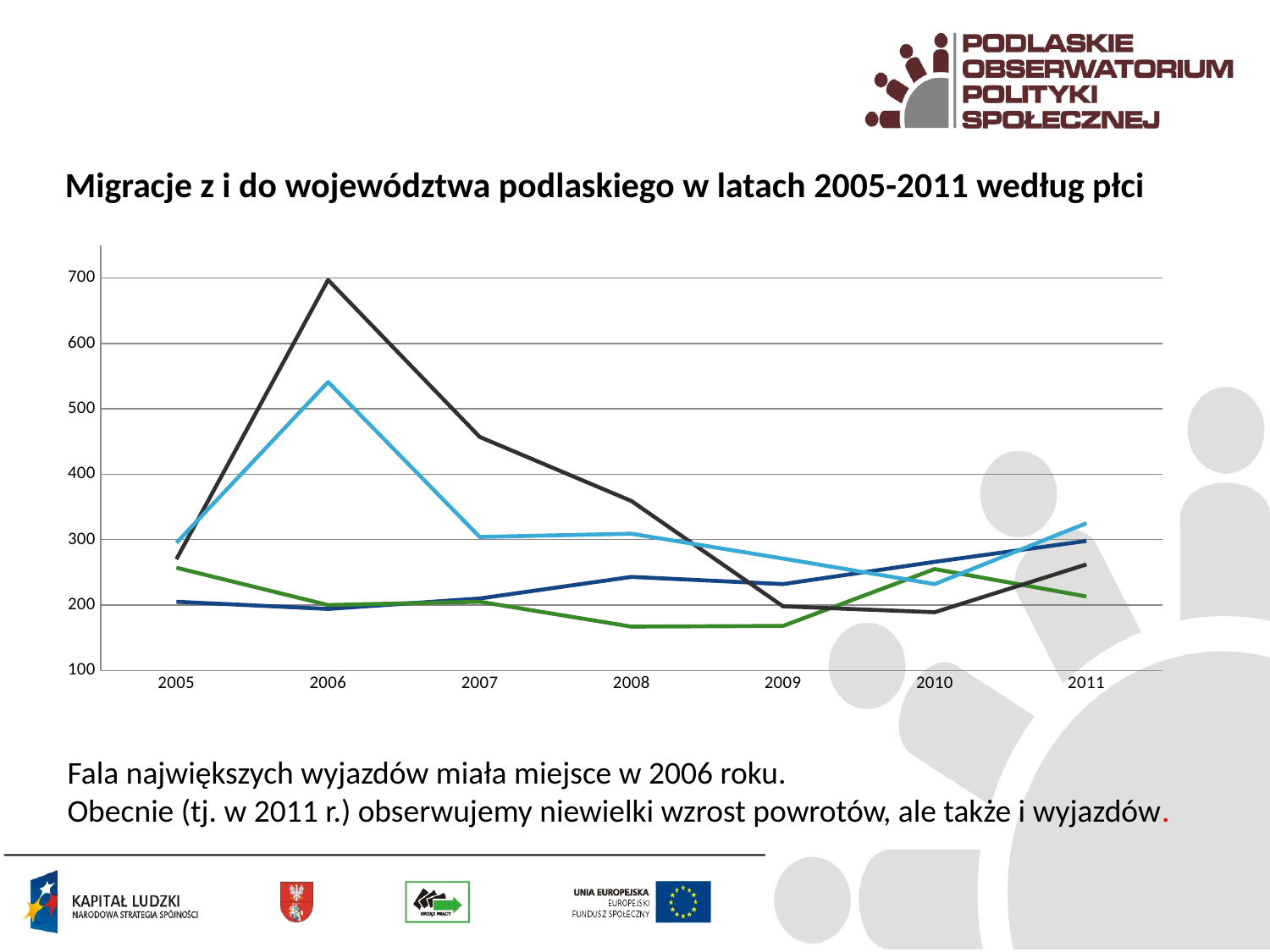
How many years are shown on the x axis of the chart? 7 Is the value of the light blue line in 2006 greater or less than 500? greater Is the value of the black line in 2006 greater or less than 600? greater How many lines are plotted on the chart? 4 In which year does the black line reach its highest value? 2006 What kind of chart is shown on the slide? line chart What is the title of the chart? Migracje z i do województwa podlaskiego w latach 2005-2011 według płci Is the value of the green line in 2008 greater or less than 200? less In which year does the light blue line reach its lowest value? 2010 In 2011, which line has the higher value, the light blue line or the green line? light blue line Does the black line rise or fall between 2006 and 2010? fall